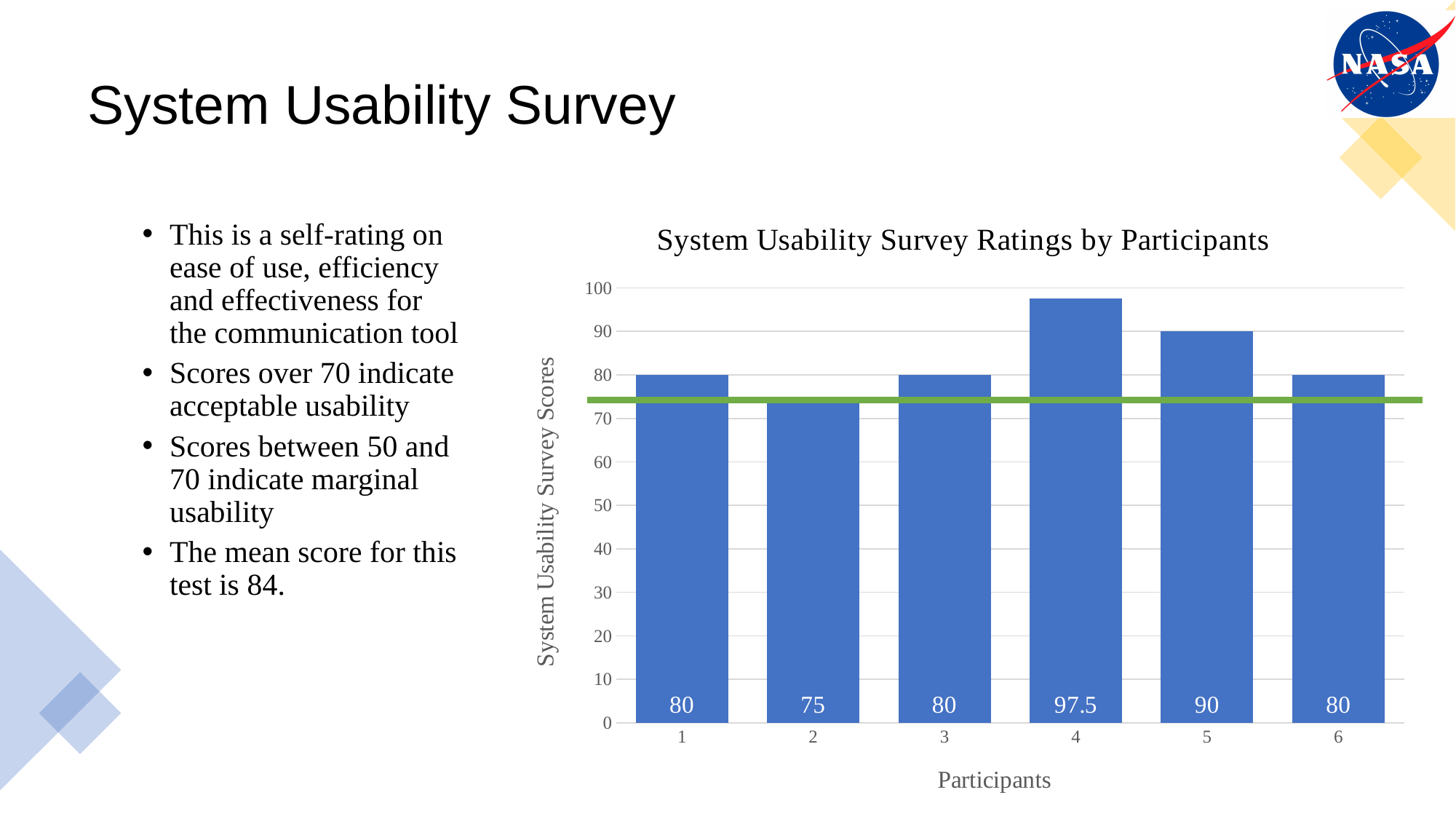
What kind of chart is used to show the System Usability Survey ratings? bar chart What is the label of the y axis of the chart? System Usability Survey Scores How many participants are shown on the x axis of the chart? 6 What is the System Usability Survey score for participant 4? 97.5 What is the title of the chart? System Usability Survey Ratings by Participants What is the System Usability Survey score for participant 2? 75 Which participant has a higher score, participant 5 or participant 6? 5 What is the System Usability Survey score for participant 5? 90 Which participant has the highest System Usability Survey score? 4 What is the difference between the scores of participant 5 and participant 1? 10 Which participant has the lowest System Usability Survey score? 2 What is the difference between the scores of participant 4 and participant 2? 22.5